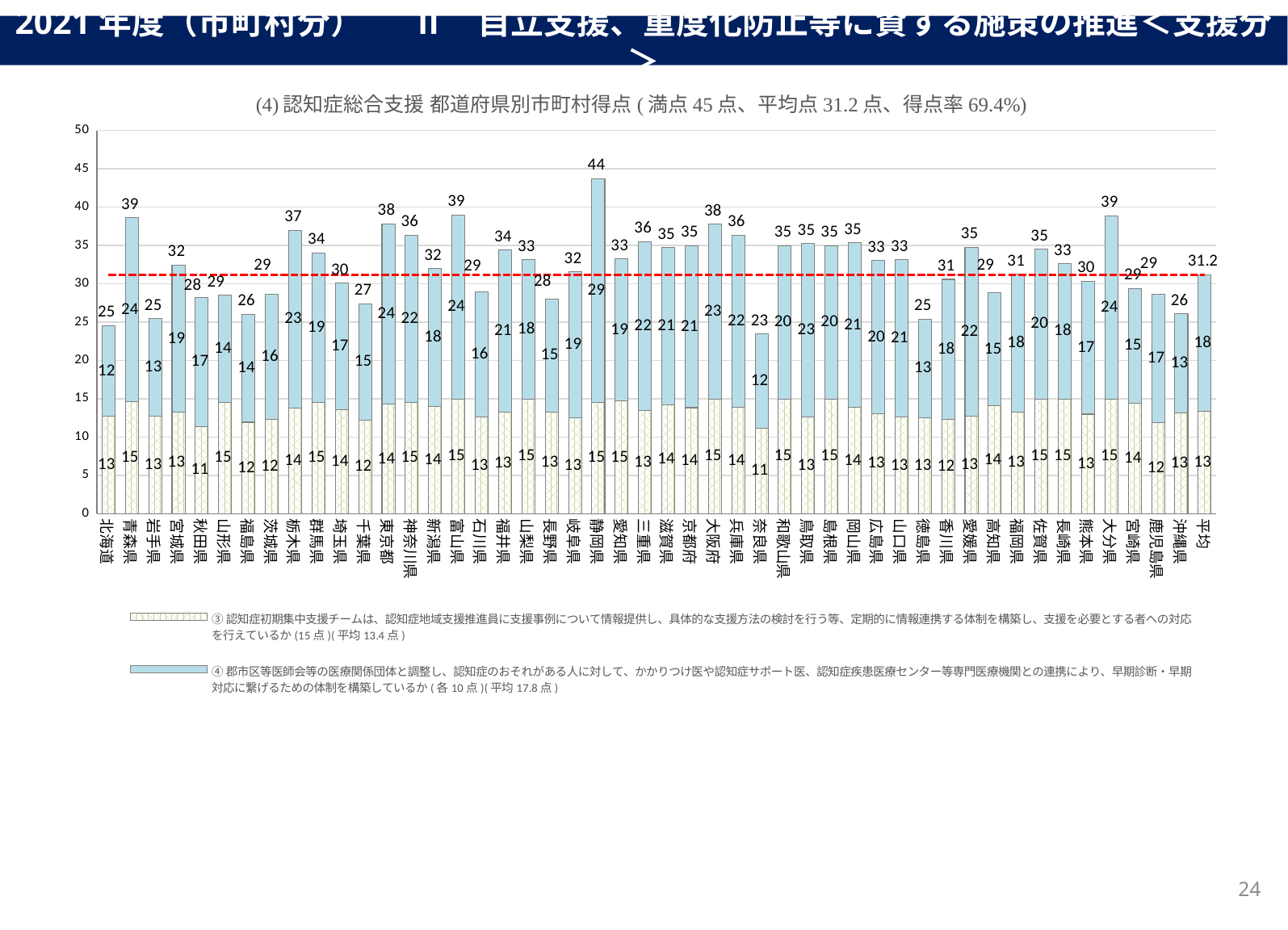
What is the total score shown for the 平均 (average) bar? 31.2 Is the total score for 静岡県 greater or less than 40? greater Which prefecture has the lowest total score? 奈良県 Which prefecture has the highest total score? 静岡県 Which has a higher total score, 青森県 or 北海道? 青森県 What is the difference between the total scores of 静岡県 and 奈良県? 21 What is the value of series ③ (hatched segment) for 北海道? 13 How many series does the legend list? 2 What is the value of series ④ (blue segment) for 奈良県? 12 What is the 満点 (maximum possible score) stated in the chart title? 45 点 What is the total score labeled for 静岡県? 44 What kind of chart is shown on the slide? bar chart